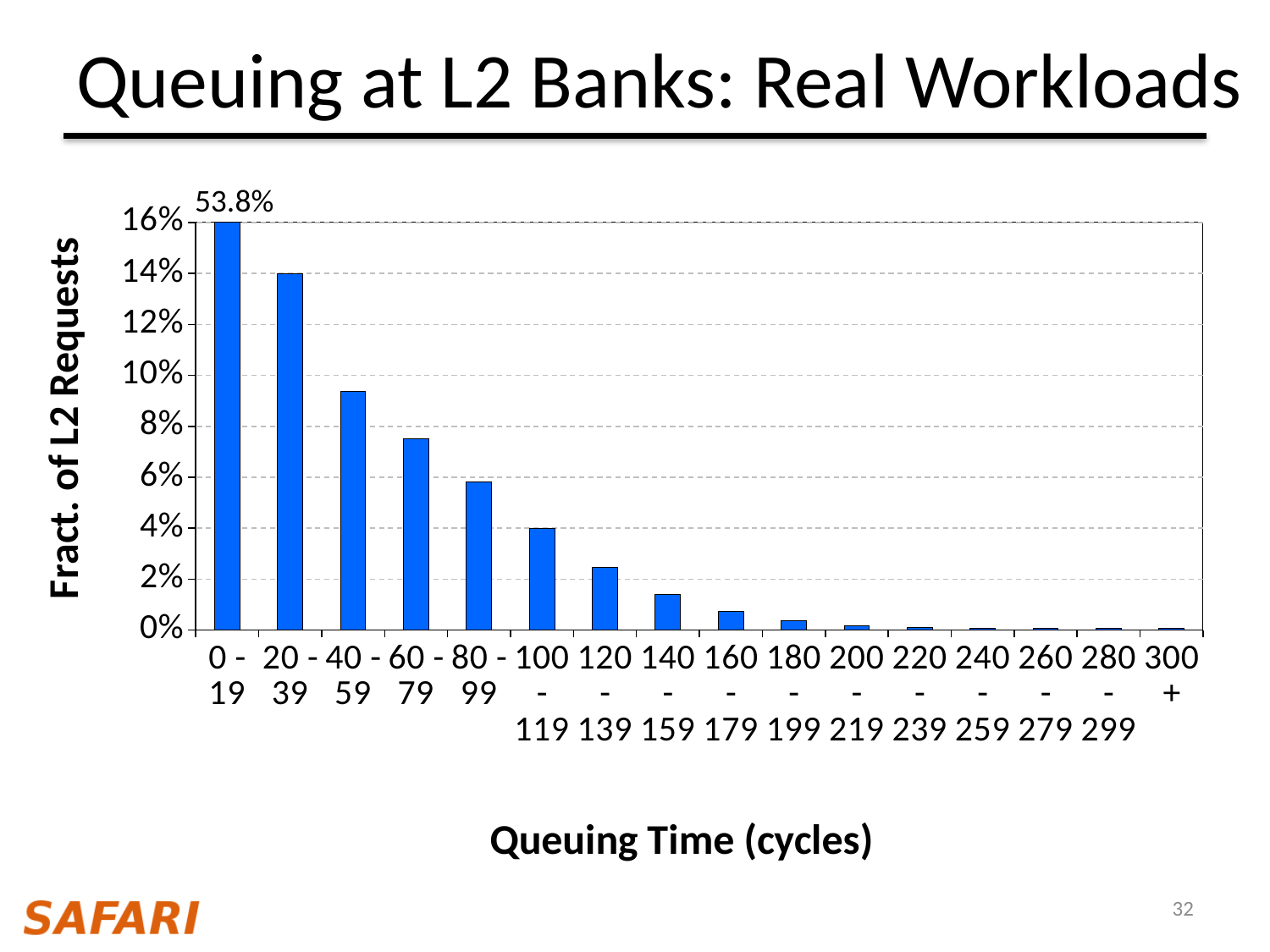
What is the title of the x axis? Queuing Time (cycles) What is the value printed for the 0 - 19 cycles category? 53.8% What kind of chart is shown on the slide? bar chart Is the value for the 20 - 39 category greater or less than 12%? greater Is the value for the 60 - 79 category greater or less than 6%? greater Is the value for the 40 - 59 category greater or less than 10%? less How many queuing time categories are shown on the x axis? 16 Which has a larger fraction of L2 requests: the 20 - 39 category or the 40 - 59 category? 20 - 39 Which queuing time category has the highest fraction of L2 requests? 0 - 19 Do the values rise or fall as queuing time increases along the x axis? fall